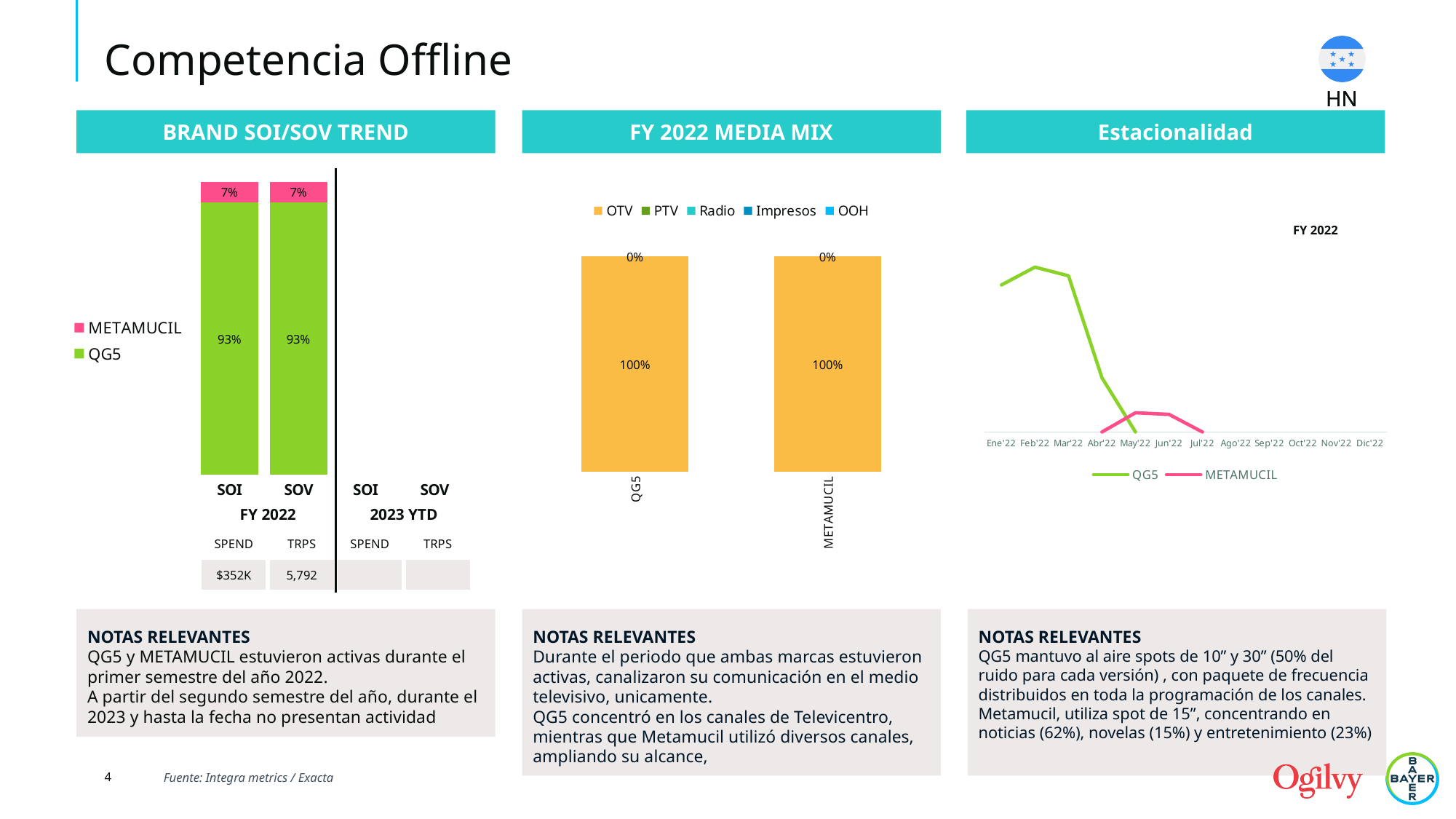
How many series does the legend of the FY 2022 MEDIA MIX chart list? 5 How many brands are shown on the x axis of the FY 2022 MEDIA MIX chart? 2 In the BRAND SOI/SOV TREND chart, what is the difference between the QG5 and METAMUCIL shares of SOV for FY 2022? 86% In the BRAND SOI/SOV TREND chart, what share does METAMUCIL have of SOV for FY 2022? 7% What kind of chart is the Estacionalidad chart? Line chart In the BRAND SOI/SOV TREND chart, what share does QG5 have of SOI for FY 2022? 93% What kind of chart is the BRAND SOI/SOV TREND chart? Stacked bar chart In the BRAND SOI/SOV TREND chart, which brand has the larger share of SOI for FY 2022? QG5 In the Estacionalidad chart, does the QG5 line rise or fall from Mar'22 to May'22? Fall In the FY 2022 MEDIA MIX chart, what percentage of QG5's media mix is OTV? 100% In the FY 2022 MEDIA MIX chart, what percentage of METAMUCIL's media mix is OTV? 100% How many series does the legend of the BRAND SOI/SOV TREND chart list? 2